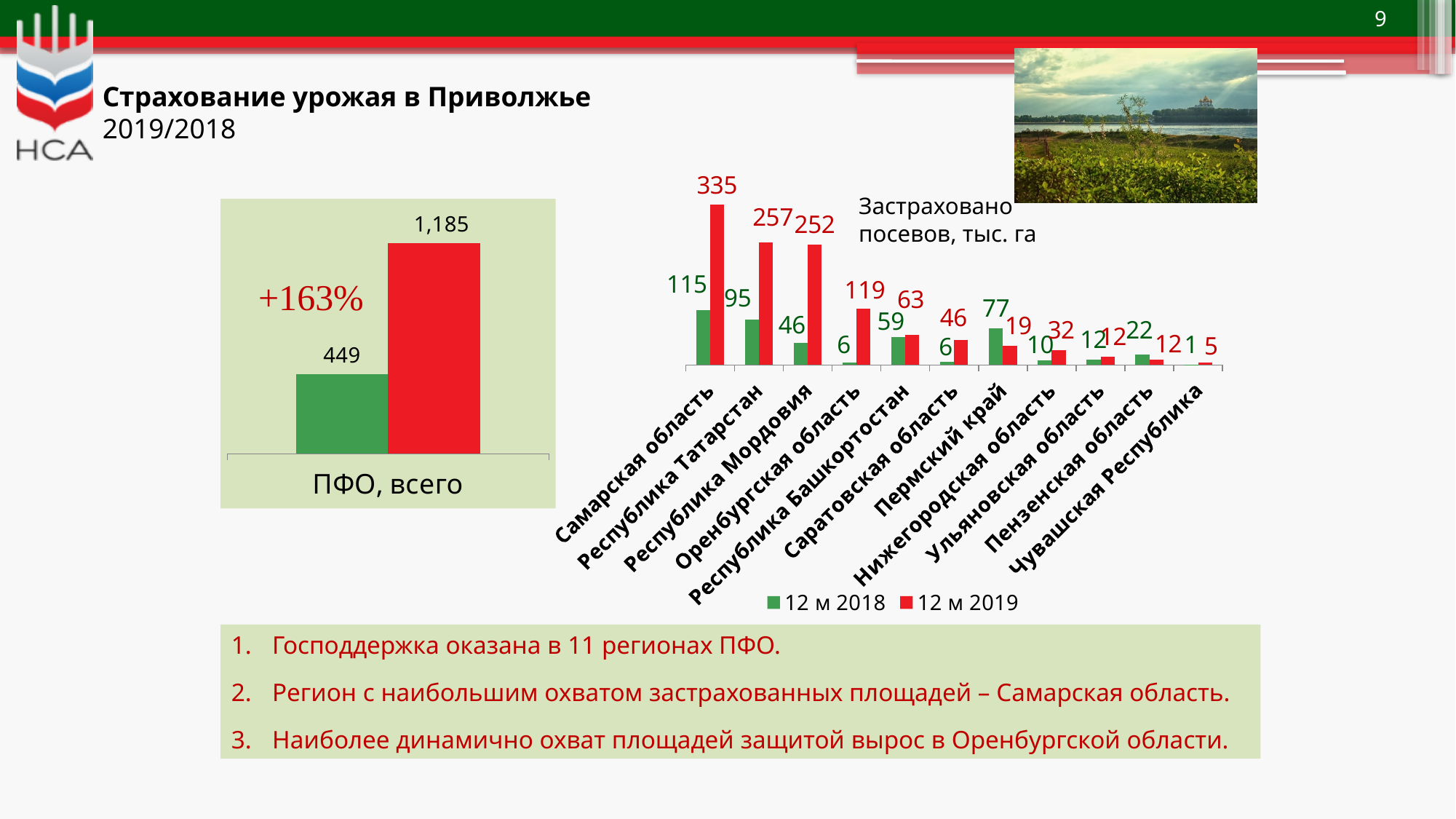
In the right chart (Застраховано посевов, тыс. га), which region has the lowest 12 м 2018 value? Чувашская Республика In the right chart (Застраховано посевов, тыс. га), which is larger for Пермский край: the 12 м 2018 value or the 12 м 2019 value? 12 м 2018 In the left chart (ПФО, всего), what is the value of the red bar? 1,185 How many series does the legend of the right chart (Застраховано посевов, тыс. га) list? 2 In the right chart (Застраховано посевов, тыс. га), what is the 12 м 2018 value for Пермский край? 77 In the right chart (Застраховано посевов, тыс. га), what is the 12 м 2019 value for Самарская область? 335 In the left chart (ПФО, всего), what percentage change is printed on the chart? +163% What type of chart is the right chart (Застраховано посевов, тыс. га)? Bar chart In the right chart (Застраховано посевов, тыс. га), what is the difference between the 12 м 2019 and 12 м 2018 values for Оренбургская область? 113 In the left chart (ПФО, всего), what is the value of the green bar? 449 How many regions are shown on the x axis of the right chart (Застраховано посевов, тыс. га)? 11 In the right chart (Застраховано посевов, тыс. га), which region has the highest 12 м 2019 value? Самарская область